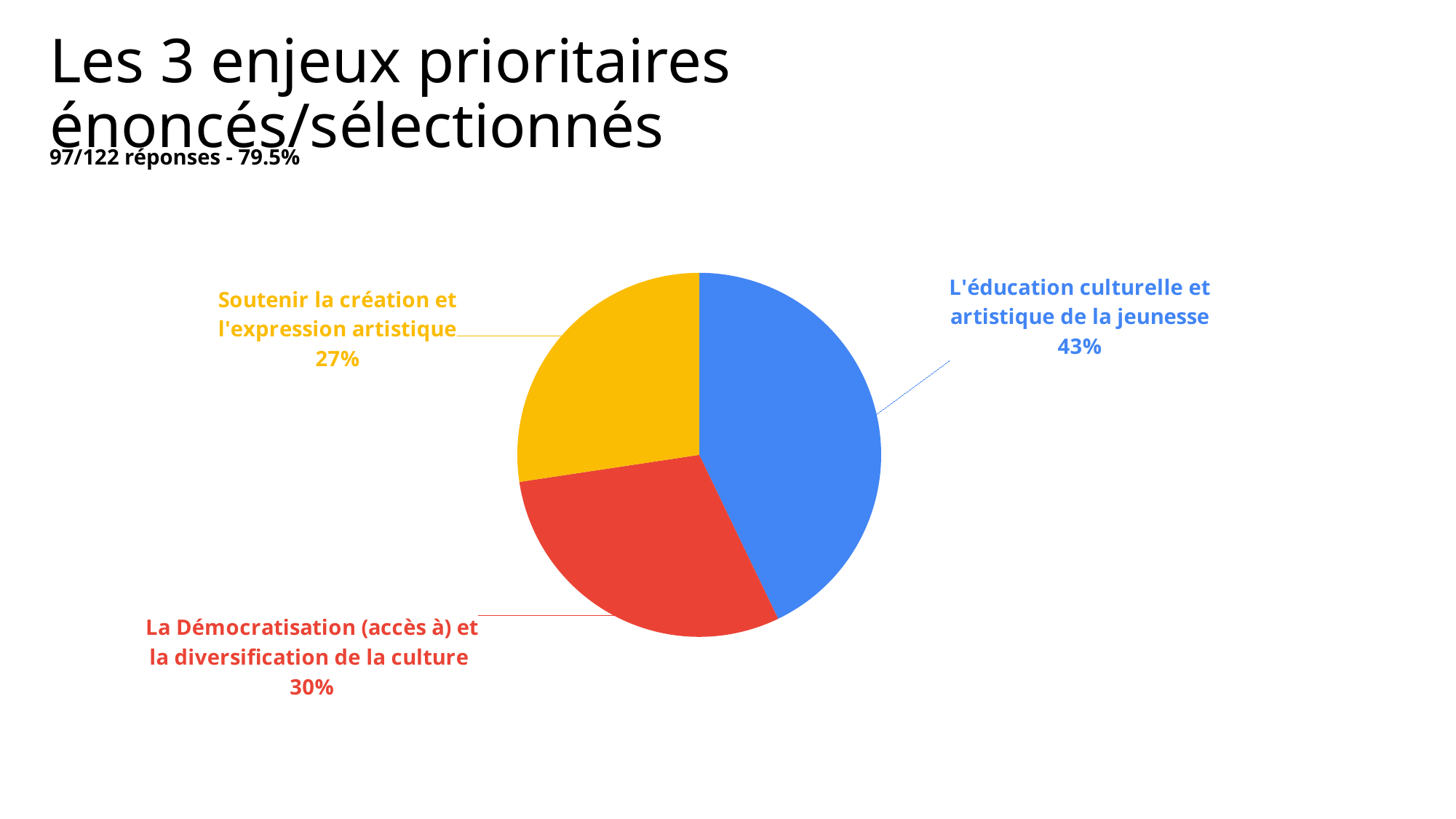
What is the title of the slide containing the pie chart? Les 3 enjeux prioritaires énoncés/sélectionnés What kind of chart is shown on the slide? pie chart How many slices does the pie chart have? 3 What share of the pie is "La Démocratisation (accès à) et la diversification de la culture"? 30% What share of the pie is "L'éducation culturelle et artistique de la jeunesse"? 43% What is the difference in percentage points between "L'éducation culturelle et artistique de la jeunesse" and "Soutenir la création et l'expression artistique"? 16 What share of the pie is "Soutenir la création et l'expression artistique"? 27% Which slice of the pie is the largest? L'éducation culturelle et artistique de la jeunesse Which is larger: the share for "La Démocratisation (accès à) et la diversification de la culture" or the share for "Soutenir la création et l'expression artistique"? La Démocratisation (accès à) et la diversification de la culture Which slice of the pie is the smallest? Soutenir la création et l'expression artistique What colour is the slice for "L'éducation culturelle et artistique de la jeunesse"? blue What is the difference in percentage points between "La Démocratisation (accès à) et la diversification de la culture" and "Soutenir la création et l'expression artistique"? 3